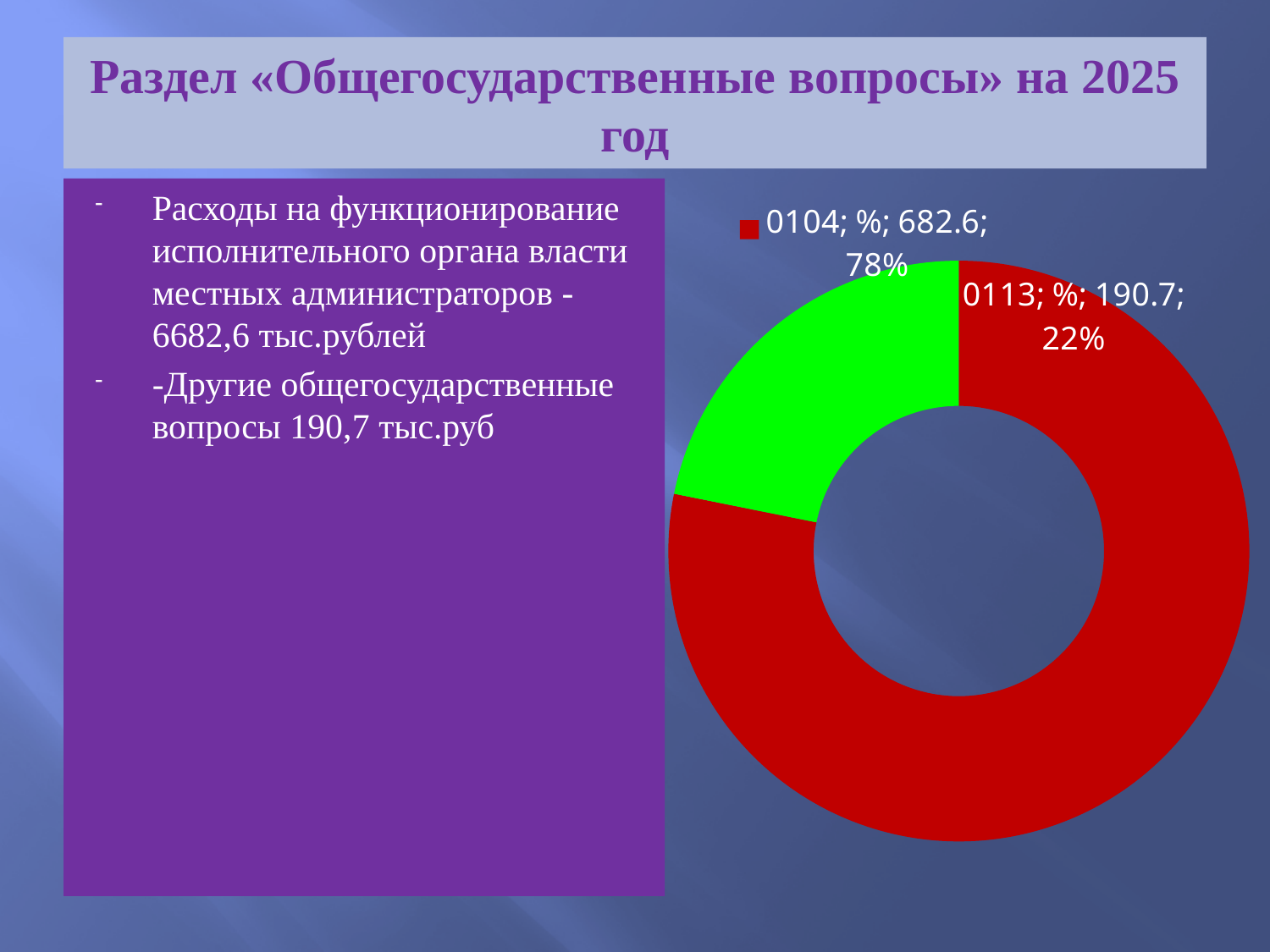
What share of the chart does the 0113 slice represent? 22% What value is shown for category 0113 on the chart? 190.7 What colour is the slice for category 0104? Red What value is shown for category 0104 on the chart? 682.6 How many categories (slices) does the chart show? 2 Which category has the smallest slice in the chart? 0113 Which is larger, the value for 0104 or the value for 0113? 0104 What share of the chart does the 0104 slice represent? 78% What colour is the slice for category 0113? Green What kind of chart is shown on the slide? Doughnut (pie) chart Which category has the largest slice in the chart? 0104 What is the difference between the values for 0104 and 0113? 491.9